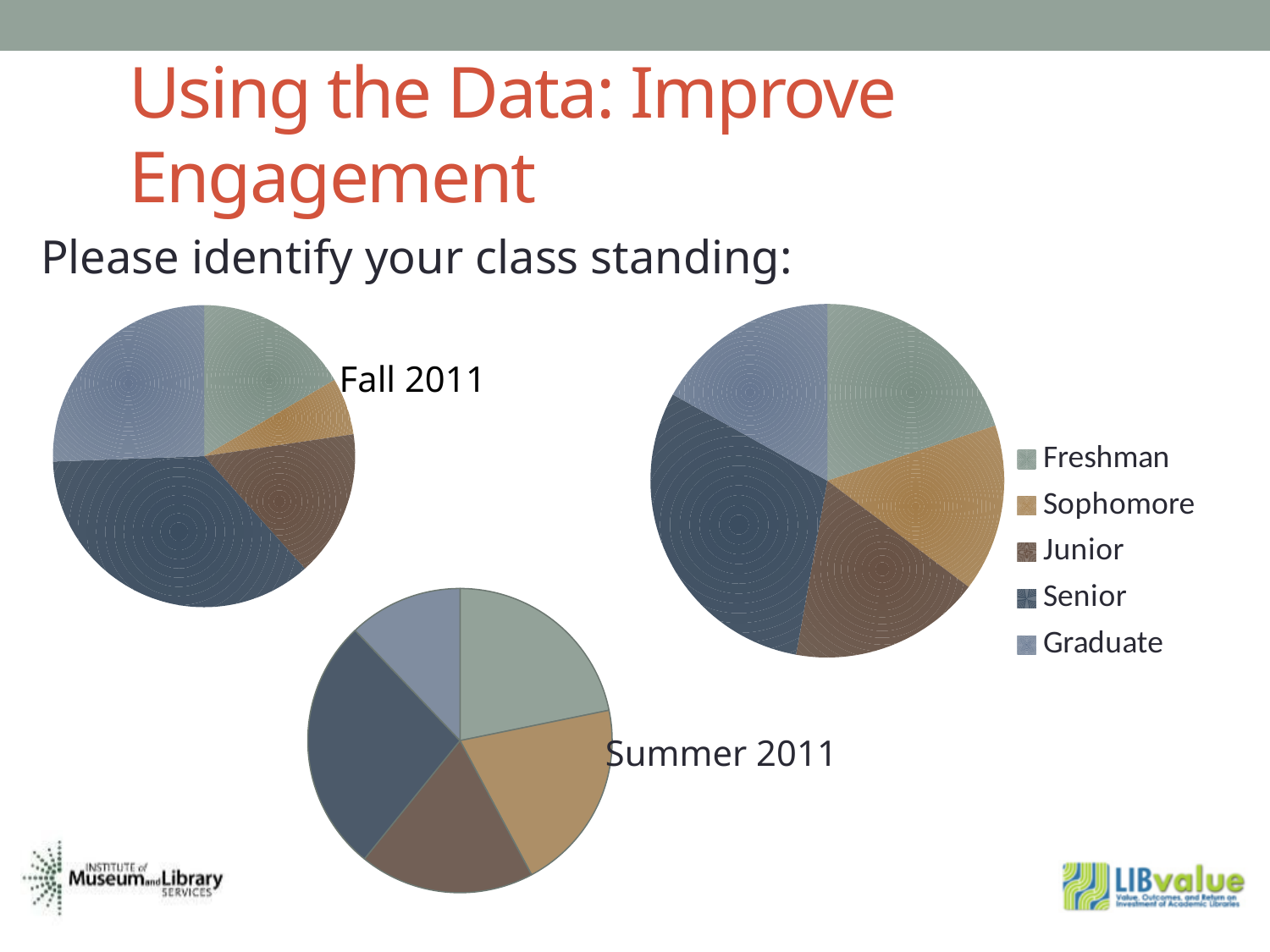
In the Fall 2011 chart, which slice is larger, Senior or Freshman? Senior In the Fall 2011 chart, which class standing has the largest slice? Senior Which class standing is listed last in the legend? Graduate What kind of chart is the Fall 2011 chart? pie chart In the Fall 2011 chart, which slice is larger, Graduate or Sophomore? Graduate In the Fall 2011 chart, which class standing has the smallest slice? Sophomore In the top-right pie chart, which class standing has the largest slice? Senior How many slices does the Summer 2011 pie chart have? 5 How many categories does the legend list for the class standing charts? 5 In the Summer 2011 chart, which class standing has the largest slice? Senior How many pie charts are shown on the slide? 3 In the Summer 2011 chart, which slice is larger, Senior or Graduate? Senior